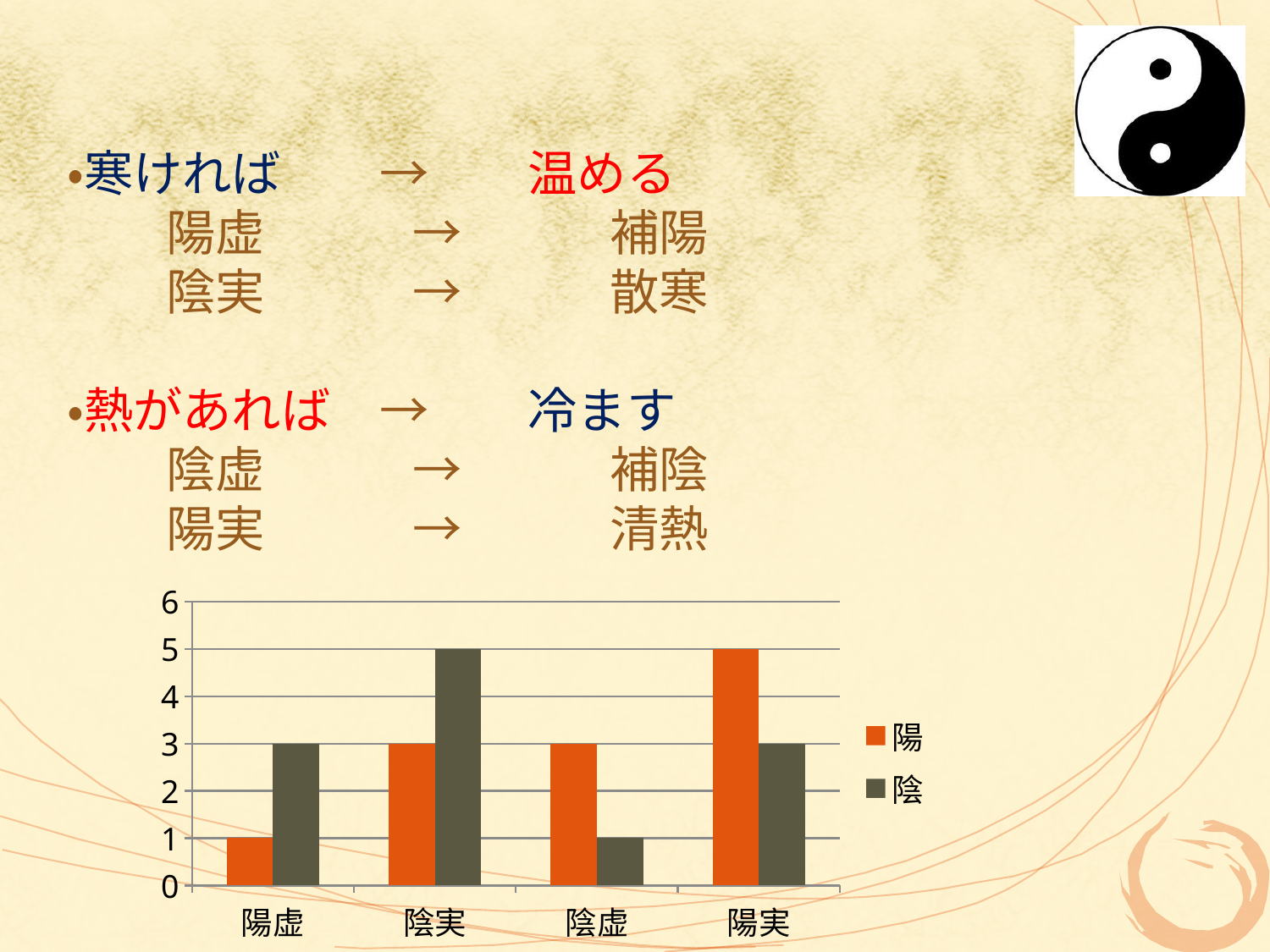
What is the value of 陰 for 陰虚? 1 What is the value of 陰 for 陰実? 5 What is the value of 陽 for 陽実? 5 How many series does the chart's legend list? 2 Which series in the legend is shown in orange? 陽 Which category has the lowest value for the 陰 series? 陰虚 What is the value of 陽 for 陽虚? 1 For 陽虚, which is larger, the 陽 value or the 陰 value? 陰 How many categories are shown on the x axis of the chart? 4 What kind of chart is shown on the slide? bar chart Which category has the highest value for the 陽 series? 陽実 What is the difference between the 陰 value and the 陽 value for 陰実? 2